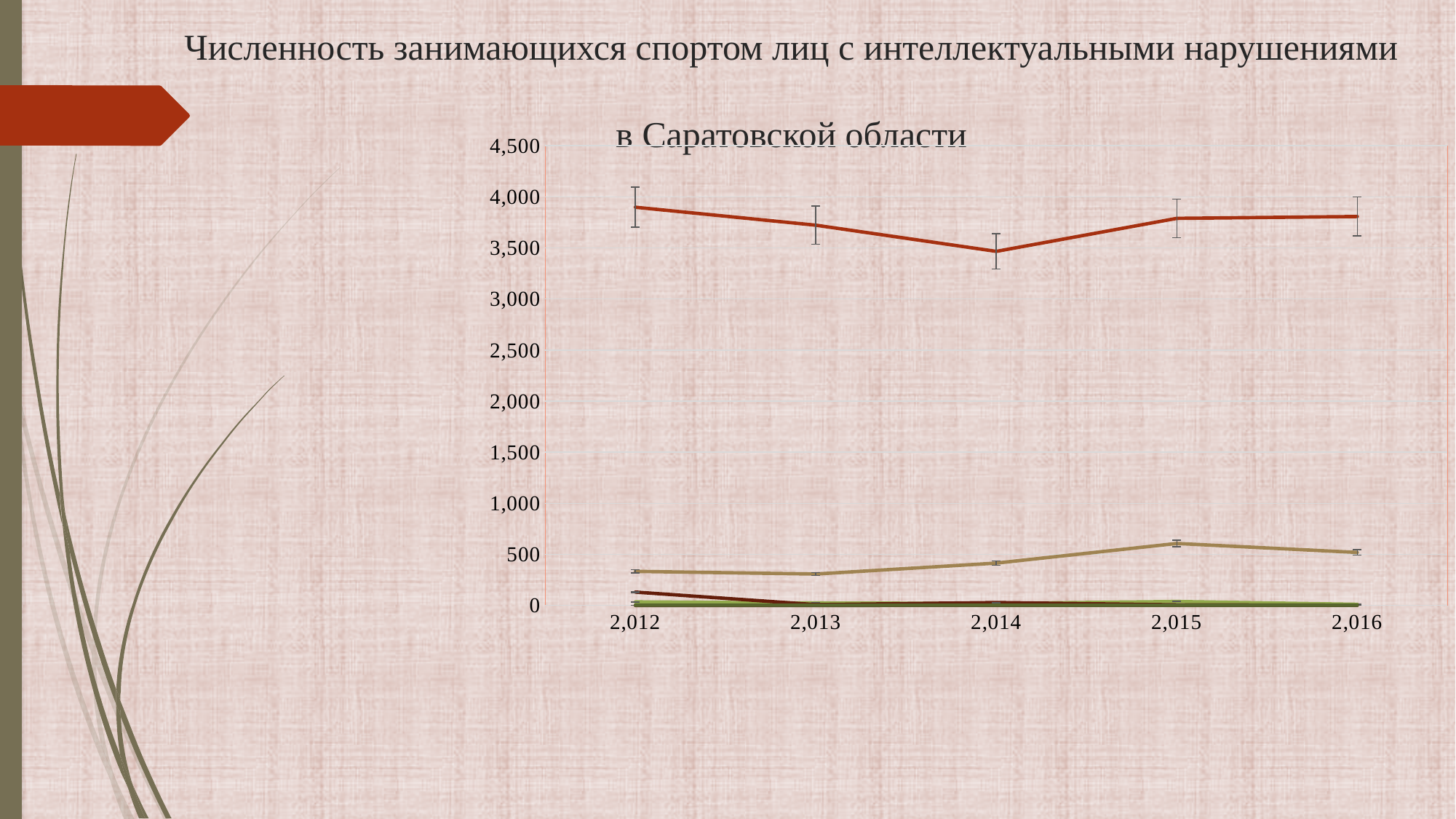
In which year is the red (top) line at its lowest point? 2,014 How many years are plotted along the x axis of the chart? 5 Is the value of the red (top) line in 2,012 greater or less than 3,500? greater What kind of chart is shown on the slide? line chart What is the last year shown on the x axis of the chart? 2,016 Does the red (top) line rise or fall between 2,012 and 2,014? fall In which year is the tan (middle) line at its highest point? 2,015 Is the value of the tan (middle) line in 2,013 greater or less than 500? less What is the first year shown on the x axis of the chart? 2,012 Which is larger: the red (top) line's value in 2,012 or its value in 2,014? 2,012 Is the value of the tan (middle) line in 2,015 greater or less than 500? greater